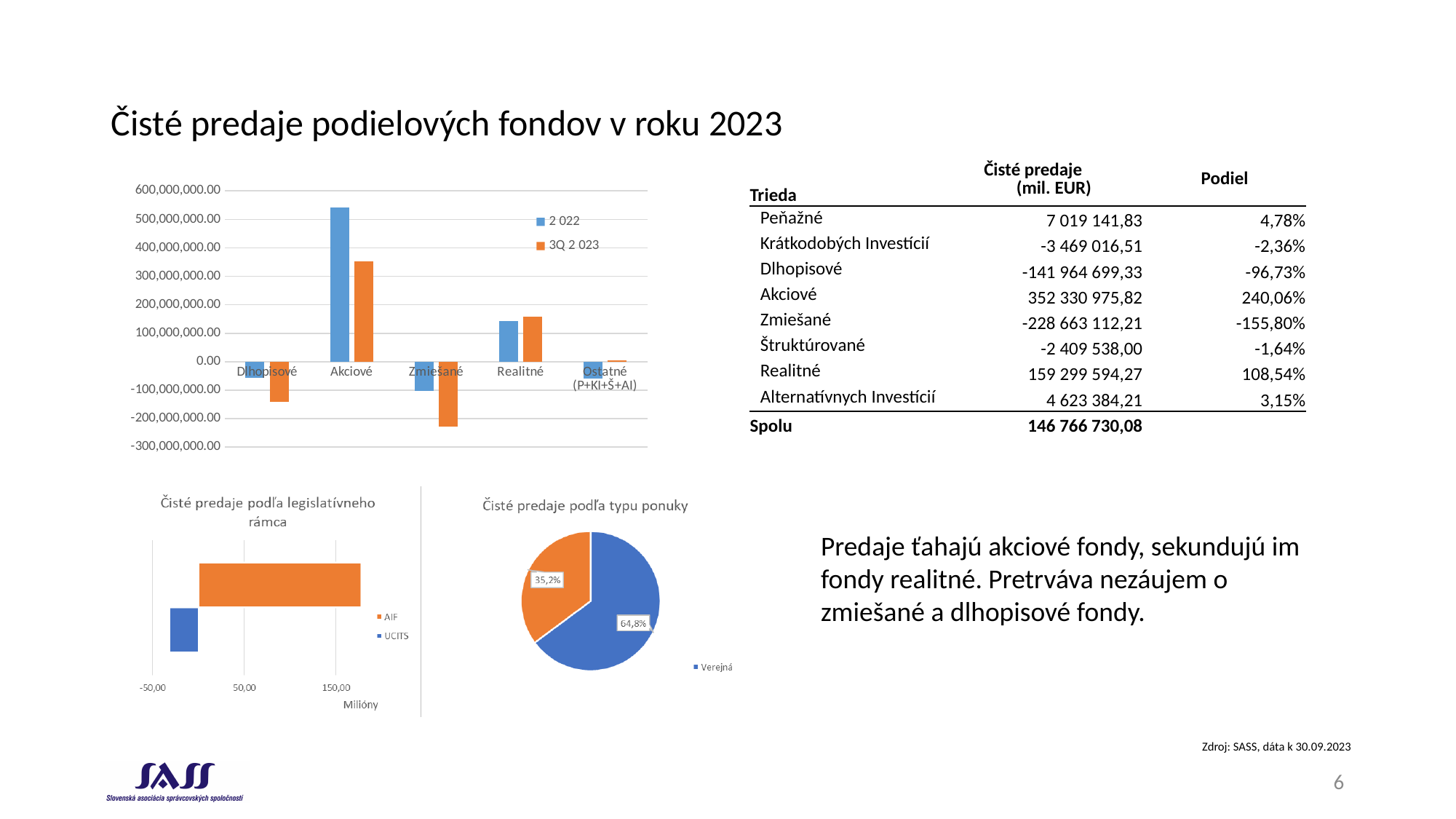
In the top-left bar chart, which is larger for Akciové: the 2 022 value or the 3Q 2 023 value? 2 022 In the pie chart 'Čisté predaje podľa typu ponuky', what is the share of the largest slice? 64,8% In the top-left bar chart, how many series does the legend list? 2 In the top-left bar chart, which category has the highest value for the 3Q 2 023 series? Akciové In the top-left bar chart, which category has the lowest value for the 3Q 2 023 series? Zmiešané In the chart 'Čisté predaje podľa legislatívneho rámca', is the value for AIF greater or less than 50,00 million? greater In the chart 'Čisté predaje podľa legislatívneho rámca', which series has the larger value: AIF or UCITS? AIF In the top-left bar chart, is the 3Q 2 023 value for Realitné greater or less than 100,000,000.00? greater In the top-left bar chart, is the 2 022 value for Akciové greater or less than 500,000,000.00? greater What kind of chart is 'Čisté predaje podľa typu ponuky'? pie chart In the top-left bar chart, how many categories are shown on the x axis? 5